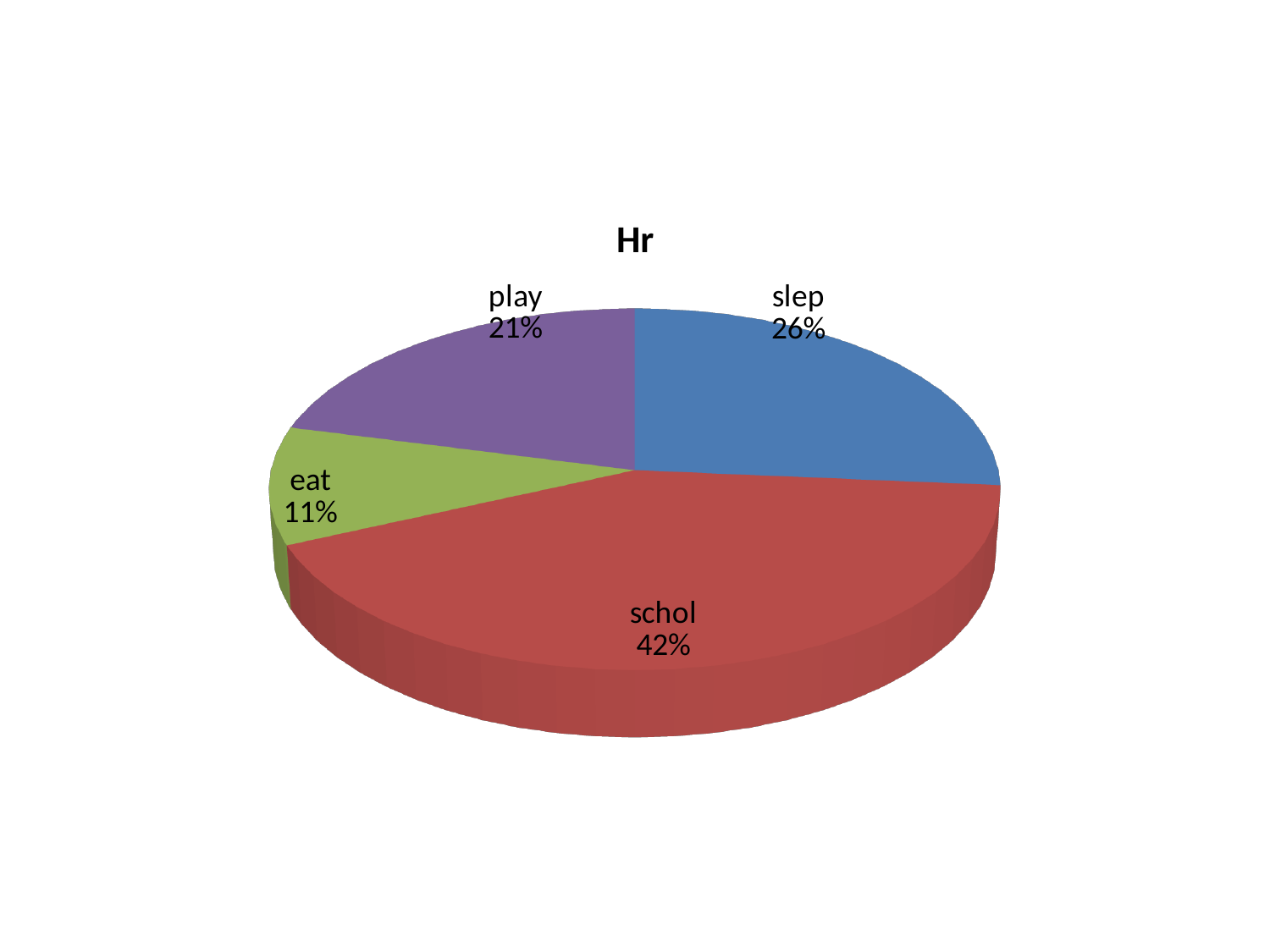
Which slice is larger, 'play' or 'eat'? play What type of chart is shown on the slide? pie chart Which category has the smallest slice of the pie? eat What is the title of the chart? Hr What is the difference in percentage points between the 'schol' and 'slep' slices? 16 How many slices does the pie chart have? 4 What share of the pie does the 'schol' slice represent? 42% What colour is the 'slep' slice? blue What share of the pie does the 'play' slice represent? 21% Which category has the largest slice of the pie? schol What share of the pie does the 'slep' slice represent? 26%